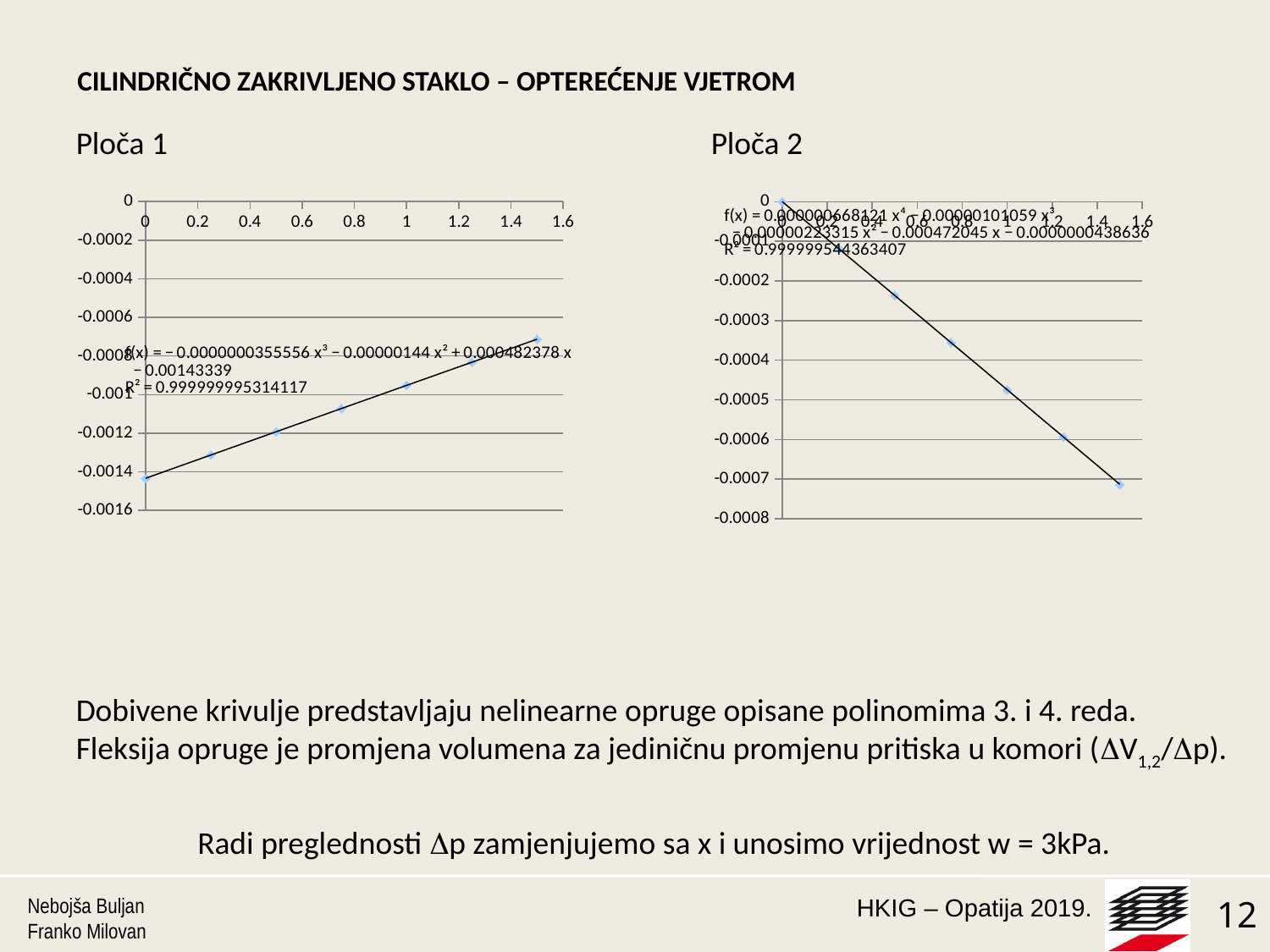
On the Ploča 1 chart, at which x value is the plotted value highest? 1.5 On the Ploča 1 chart, which is larger: the value at x = 1 or the value at x = 0.25? the value at x = 1 What R² value is printed on the Ploča 2 chart? 0.999999544363407 On the Ploča 2 chart, do the values rise or fall as x increases? fall How many data points are plotted on the Ploča 1 chart? 7 On the Ploča 2 chart, at which x value is the plotted value lowest? 1.5 How many data points are plotted on the Ploča 2 chart? 7 On the Ploča 2 chart, is the value at x = 0.75 greater or less than -0.0004? greater On the Ploča 1 chart, is the value at x = 1.5 greater or less than -0.0008? greater On the Ploča 2 chart, is the value at x = 0.5 greater or less than -0.0002? less What kind of chart is the Ploča 1 chart? scatter chart with a trendline On the Ploča 1 chart, do the values rise or fall as x increases? rise